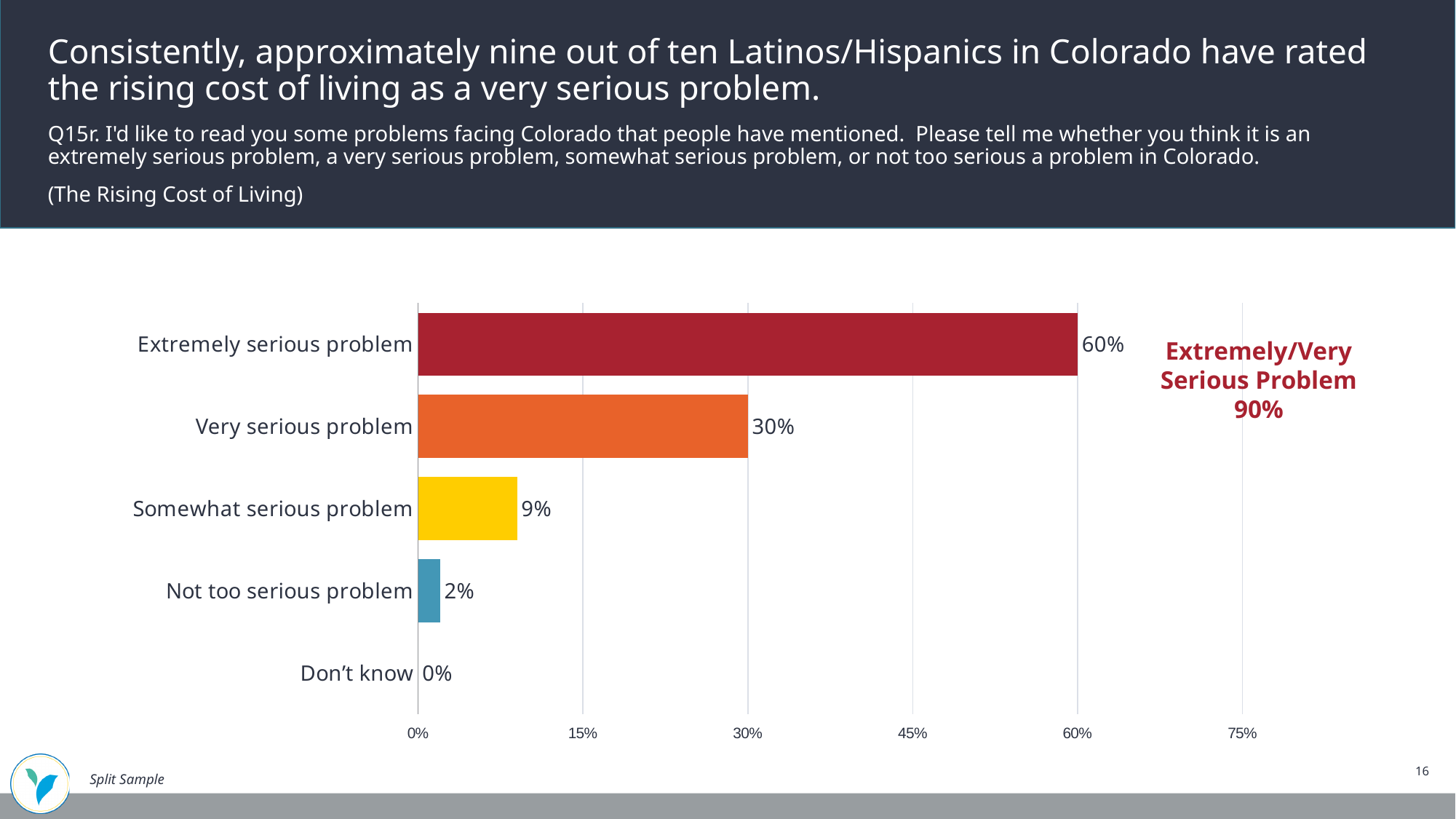
Which category has the highest value? Extremely serious problem What is the value for 'Not too serious problem'? 2% Which is larger, 'Somewhat serious problem' or 'Not too serious problem'? Somewhat serious problem What combined percentage is shown for 'Extremely/Very Serious Problem' in the annotation next to the chart? 90% Which category has the lowest value? Don't know What kind of chart is shown on the slide? Bar chart What percentage rated the rising cost of living as an extremely serious problem? 60% How many categories are shown in the chart? 5 What percentage rated the rising cost of living as a very serious problem? 30% What is the value for 'Somewhat serious problem'? 9% What is the value for 'Don't know'? 0% What is the difference between 'Extremely serious problem' and 'Very serious problem'? 30 percentage points